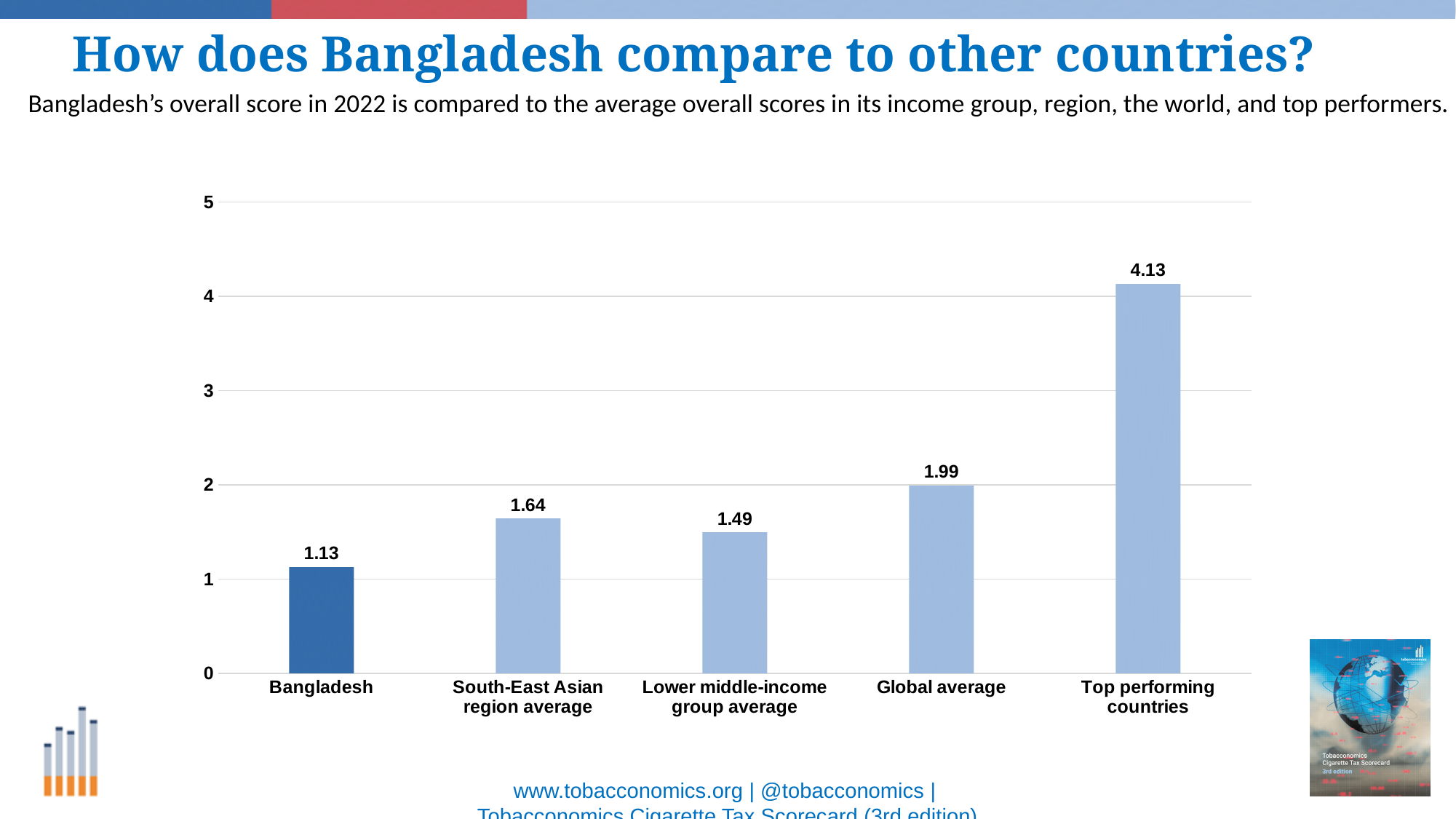
Which category has the highest value? Top performing countries What is the value for the Global average? 1.99 What is the value for the South-East Asian region average? 1.64 What is the value for the Lower middle-income group average? 1.49 What is the difference between the Global average and the South-East Asian region average? 0.35 What is the difference between the Top performing countries value and the Bangladesh value? 3.00 What is the overall score for Bangladesh? 1.13 What kind of chart is shown on the slide? Bar chart Is the value for Top performing countries greater or less than 4? greater Which is larger, the South-East Asian region average or the Lower middle-income group average? South-East Asian region average Which category has the lowest value? Bangladesh How many categories are shown in the chart? 5